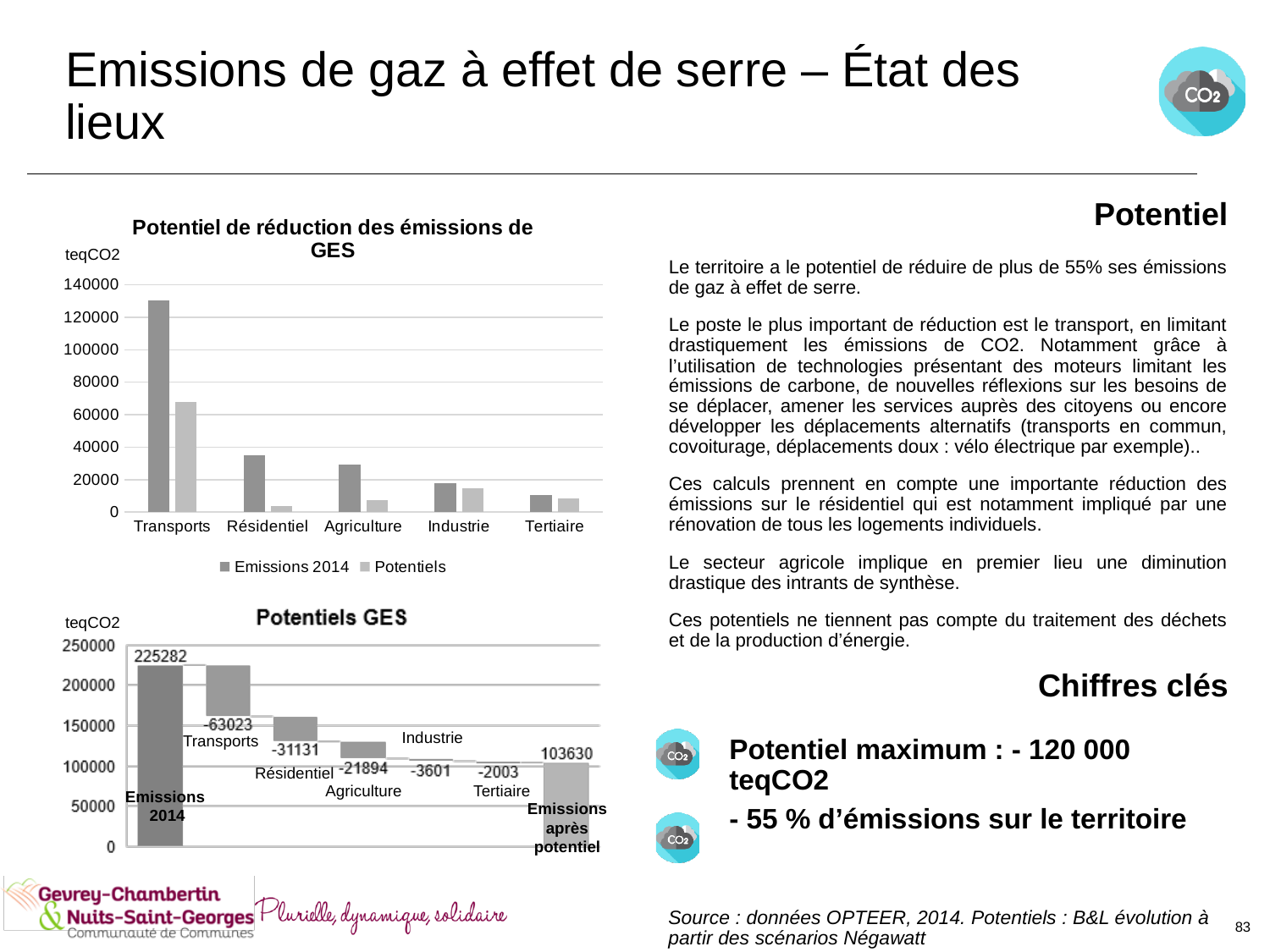
What type of chart is the chart titled 'Potentiel de réduction des émissions de GES'? bar chart In the chart titled 'Potentiel de réduction des émissions de GES', how many series does the legend list? 2 In the chart titled 'Potentiels GES', what is the value labelled for Emissions 2014? 225282 In the chart titled 'Potentiel de réduction des émissions de GES', which category has the lowest Emissions 2014 value? Tertiaire In the chart titled 'Potentiel de réduction des émissions de GES', which category has the highest Emissions 2014 value? Transports In the chart titled 'Potentiels GES', what is the value labelled for Emissions après potentiel? 103630 In the chart titled 'Potentiels GES', what is the difference between the Emissions 2014 value (225282) and the Emissions après potentiel value (103630)? 121652 In the chart titled 'Potentiel de réduction des émissions de GES', how many categories are shown on the x axis? 5 In the chart titled 'Potentiel de réduction des émissions de GES', which is larger for Agriculture: Emissions 2014 or Potentiels? Emissions 2014 In the chart titled 'Potentiel de réduction des émissions de GES', is the Potentiels value for Résidentiel greater or less than 20000? less In the chart titled 'Potentiel de réduction des émissions de GES', is the Emissions 2014 value for Transports greater or less than 120000? greater In the chart titled 'Potentiels GES', what is the value labelled for Transports? -63023